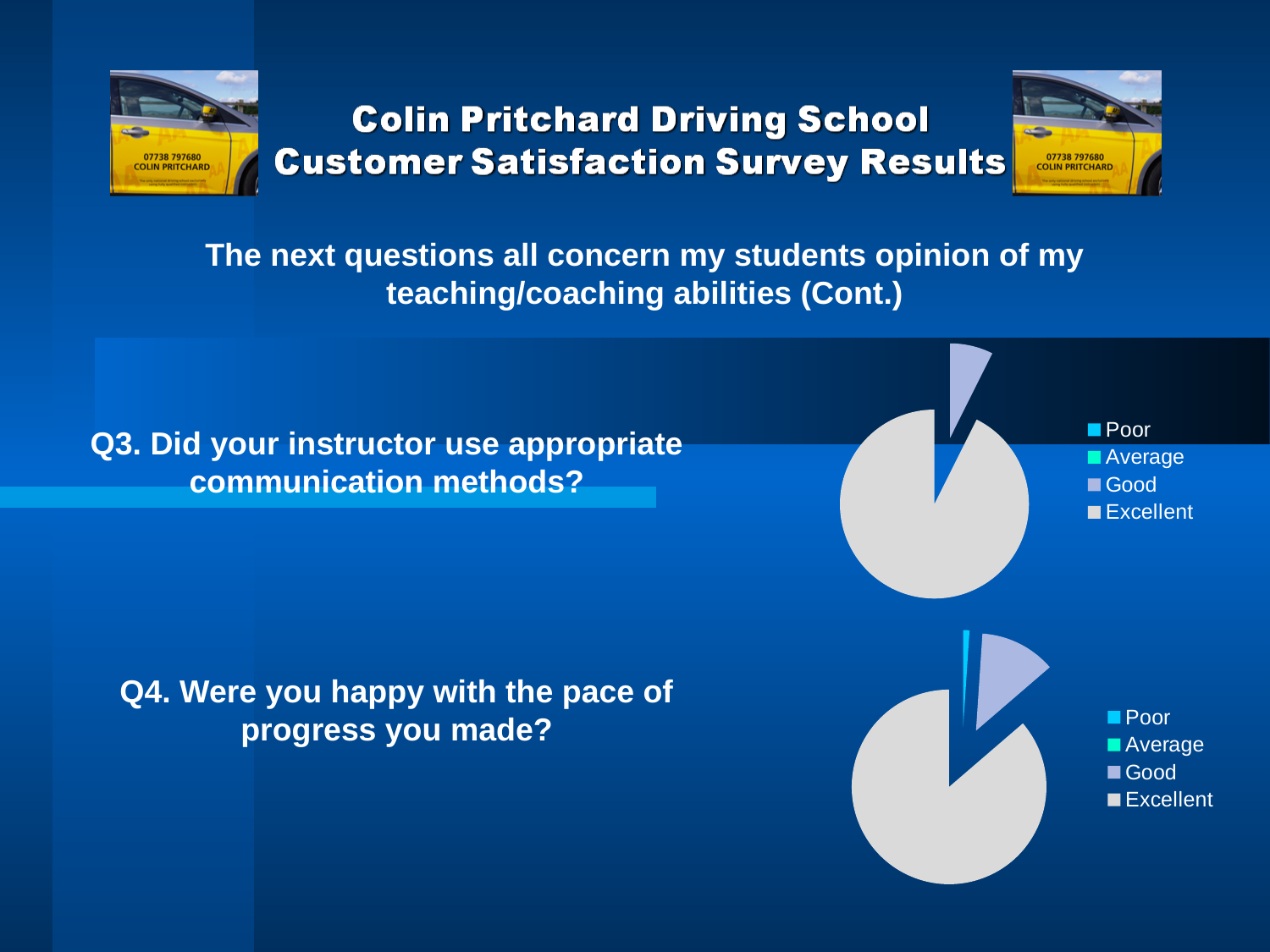
In the Q4 pie chart, what colour is the Excellent slice? Grey In the Q3 pie chart, which category has the largest slice? Excellent How many categories does the legend of the Q3 pie chart list? 4 In the Q4 pie chart, which is larger, the Excellent slice or the Good slice? Excellent In the Q4 pie chart, which is larger, the Good slice or the Average slice? Good In the Q4 pie chart, which category has the largest slice? Excellent What are the legend entries of the Q3 pie chart, in order? Poor, Average, Good, Excellent In the Q3 pie chart, which is larger, the Excellent slice or the Good slice? Excellent How many categories does the legend of the Q4 pie chart list? 4 What kind of chart is used for Q4 (Were you happy with the pace of progress you made?)? Pie chart What kind of chart is used for Q3 (Did your instructor use appropriate communication methods?)? Pie chart